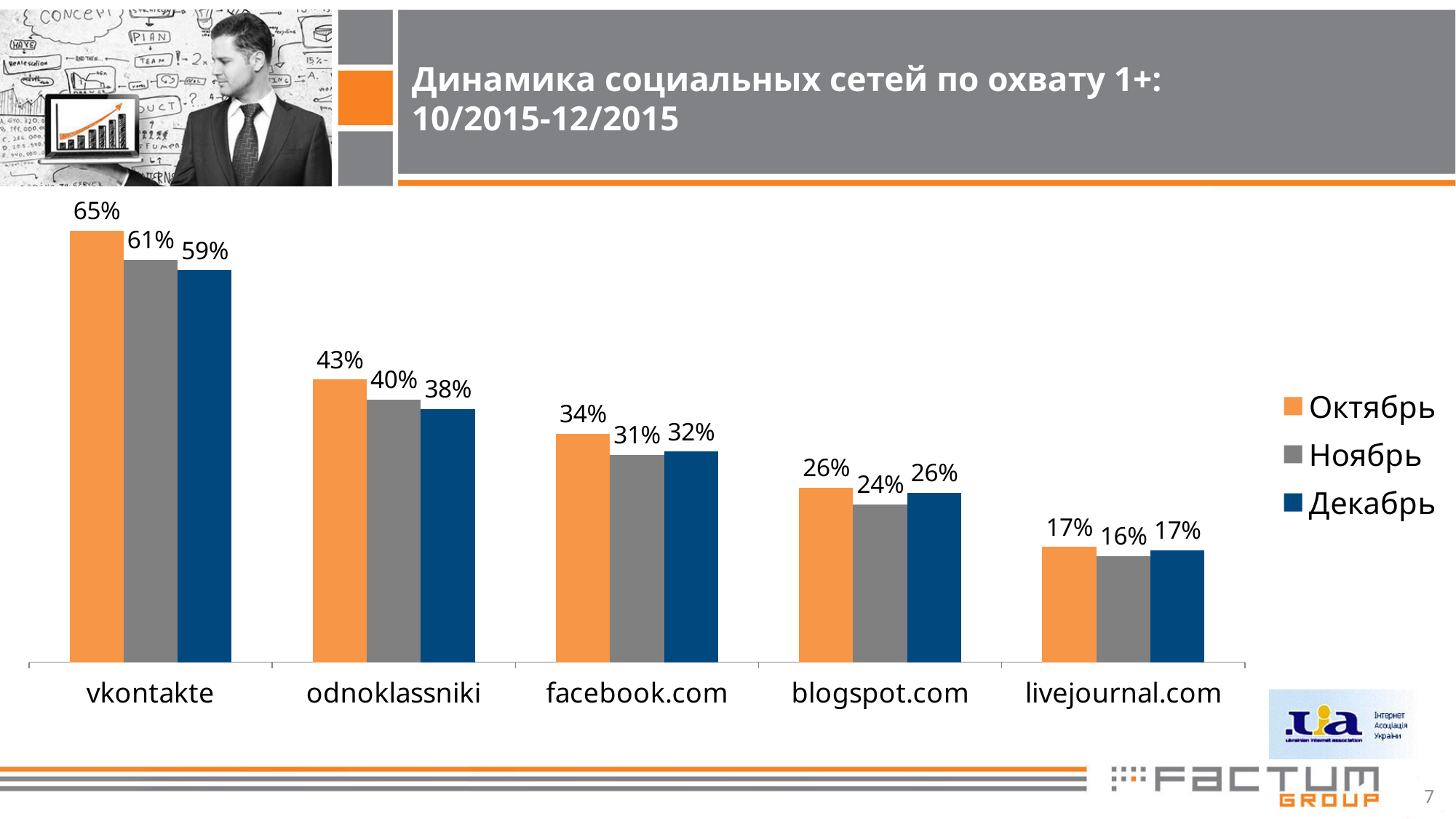
Which is larger for blogspot.com: the Октябрь value or the Ноябрь value? Октябрь What is the value for facebook.com in the Ноябрь series? 31% What kind of chart is shown on the slide? bar chart What is the value for vkontakte in the Октябрь series? 65% Do the Октябрь values rise or fall from vkontakte to livejournal.com along the x axis? fall How many series does the legend list? 3 What is the difference between the Октябрь values for odnoklassniki and facebook.com? 9% Which category has the highest value in the Декабрь series? vkontakte How many categories are shown on the x axis? 5 Which category has the lowest value in the Октябрь series? livejournal.com What is the value for livejournal.com in the Декабрь series? 17% What is the difference between the Октябрь and Декабрь values for vkontakte? 6%